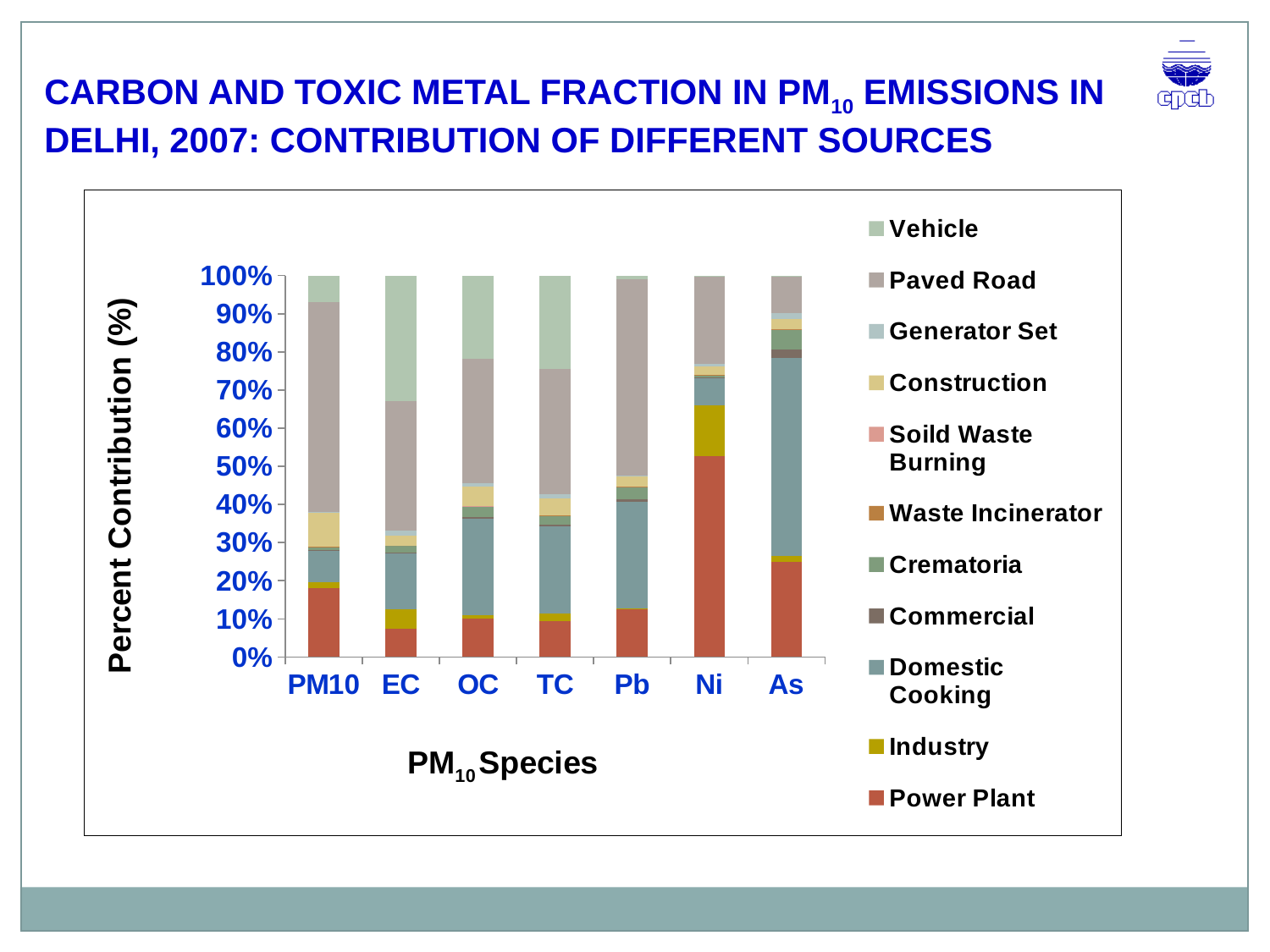
What kind of chart is shown on the slide? stacked bar chart Which species has the largest Power Plant contribution? Ni Is the Power Plant contribution for Ni greater or less than 50%? greater What is the y-axis title of the chart? Percent Contribution (%) Is the Vehicle contribution for EC greater or less than 30%? greater What is the total height of the PM10 stacked bar? 100% Is the Power Plant contribution for PM10 greater or less than 20%? less Which source is listed last in the legend? Power Plant Which species has the larger Vehicle contribution, EC or PM10? EC How many sources does the legend list? 11 How many PM10 species (categories) are shown on the x axis? 7